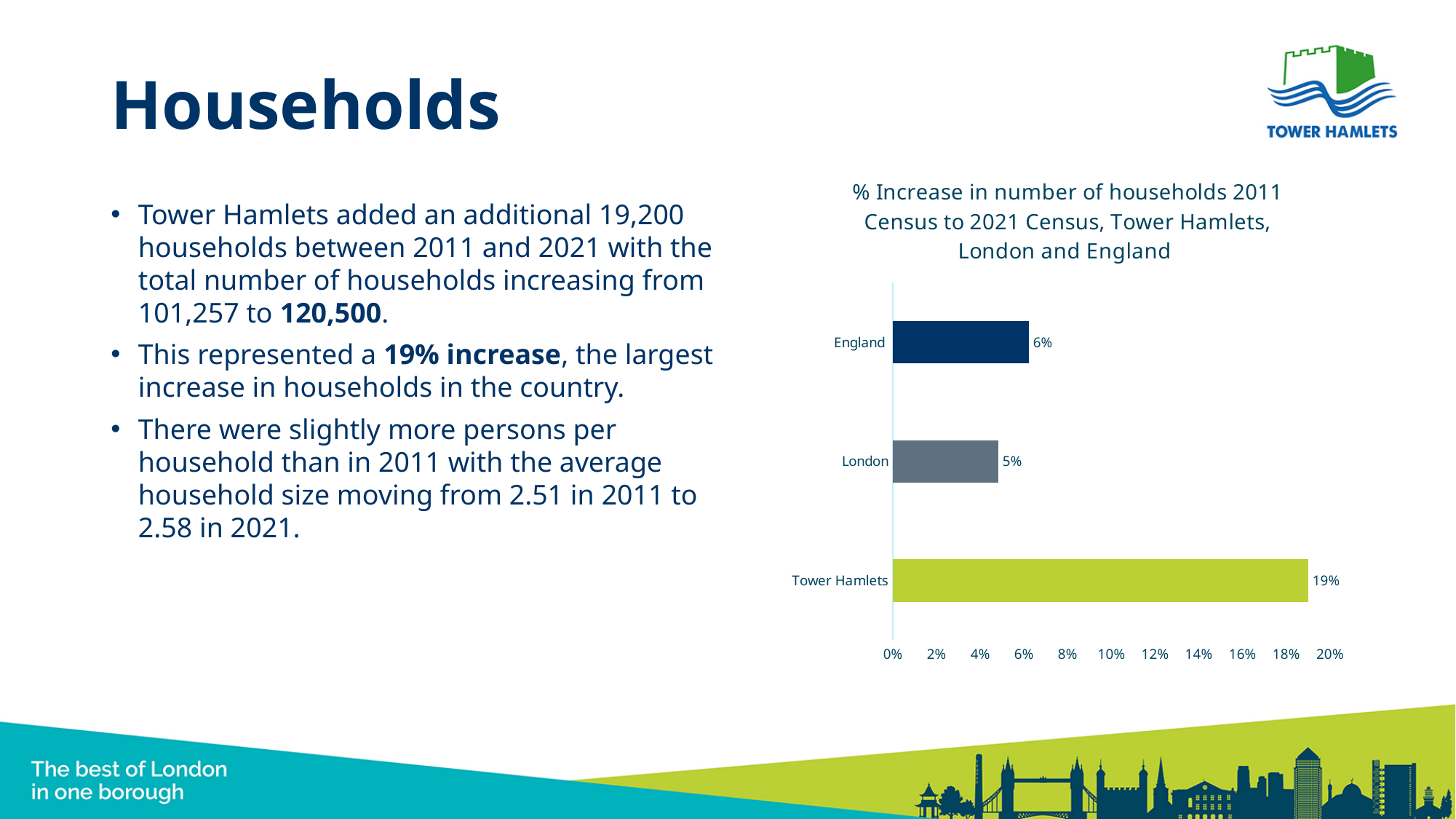
What is the % increase in number of households for London? 5% What is the difference between the % increase for Tower Hamlets and England? 13% What is the % increase in number of households for England? 6% What is the difference between the % increase for England and London? 1% Which area has the lowest % increase in number of households? London Which area has the highest % increase in number of households? Tower Hamlets How many areas are shown in the chart? 3 What is the % increase in number of households for Tower Hamlets? 19% What is the title of the chart? % Increase in number of households 2011 Census to 2021 Census, Tower Hamlets, London and England What kind of chart is shown on the slide? Bar chart Is the value for Tower Hamlets greater or less than 10%? greater Which has a larger % increase in households, Tower Hamlets or London? Tower Hamlets